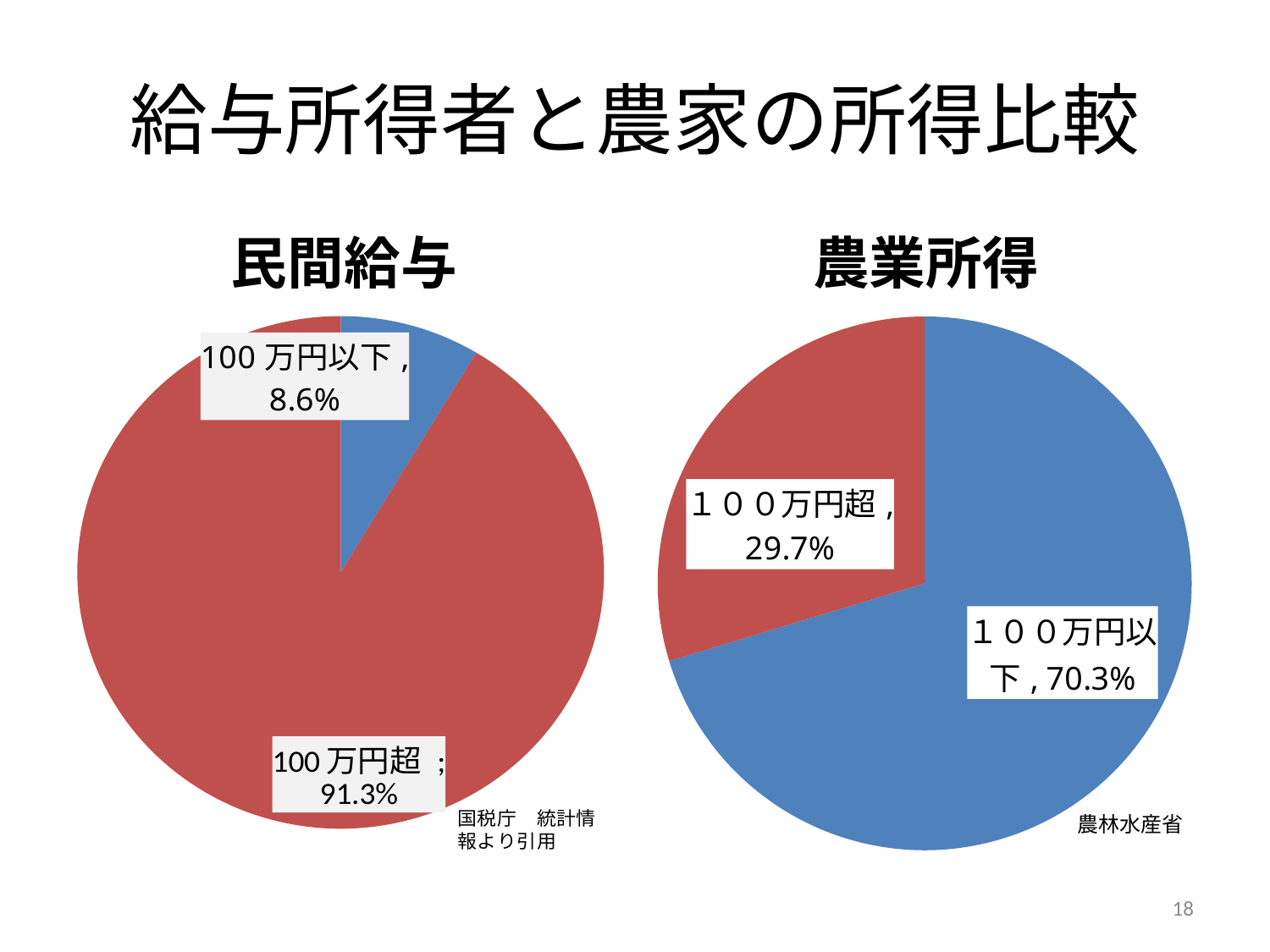
In the 民間給与 chart, what share is labelled for 100万円以下? 8.6% How many slices does the 民間給与 chart have? 2 What type of chart is the 農業所得 chart? Pie chart In the 農業所得 chart, what is the difference between the 100万円以下 and 100万円超 shares? 40.6% In the 農業所得 chart, what share is labelled for 100万円以下? 70.3% In the 民間給与 chart, which slice is the largest? 100万円超 In the 農業所得 chart, what share is labelled for 100万円超? 29.7% In the 農業所得 chart, which is larger: 100万円以下 or 100万円超? 100万円以下 What is the difference between the 100万円以下 share in the 農業所得 chart and the 100万円以下 share in the 民間給与 chart? 61.7% In the 農業所得 chart, which slice is the smallest? 100万円超 What is the title of the chart on the left side of the slide? 民間給与 In the 民間給与 chart, what share is labelled for 100万円超? 91.3%